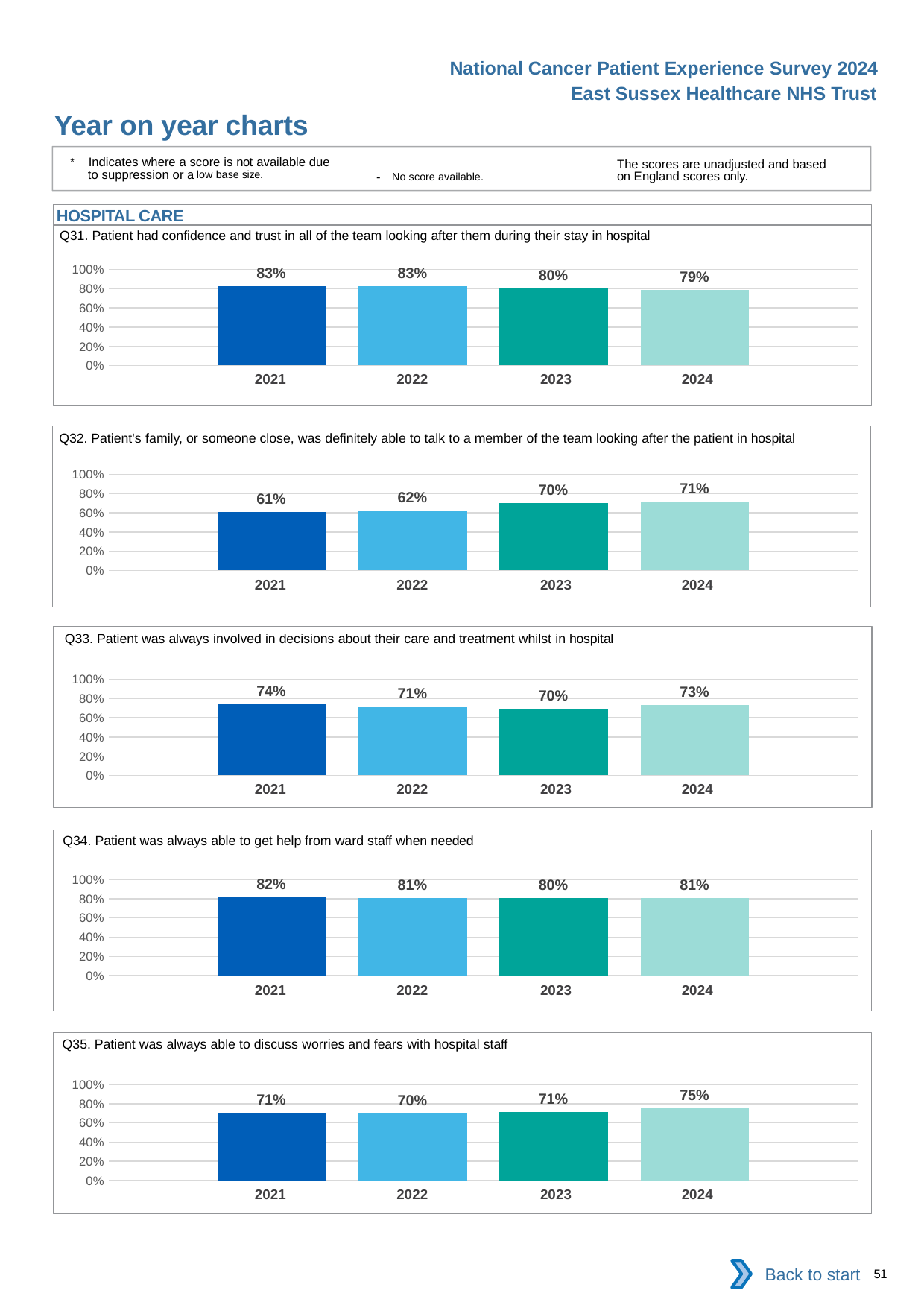
In the Q31 chart, what is the value for 2024? 79% What kind of chart is the Q31 chart? bar chart In the Q32 chart, do the values generally rise or fall from 2021 to 2024? rise In the Q32 chart, which year has the lowest value? 2021 In the Q34 chart, is the value for 2021 larger or smaller than the value for 2023? larger In the Q32 chart, what is the difference between the 2024 and 2021 values? 10 percentage points In the Q33 chart, which year has the highest value? 2021 In the Q31 chart, is the value for 2023 greater or less than 60%? greater In the Q33 chart, what is the value for 2022? 71% In the Q34 chart, how many years are plotted? 4 In the Q35 chart, which year has the highest value? 2024 In the Q35 chart, what is the difference between the 2024 and 2023 values? 4 percentage points